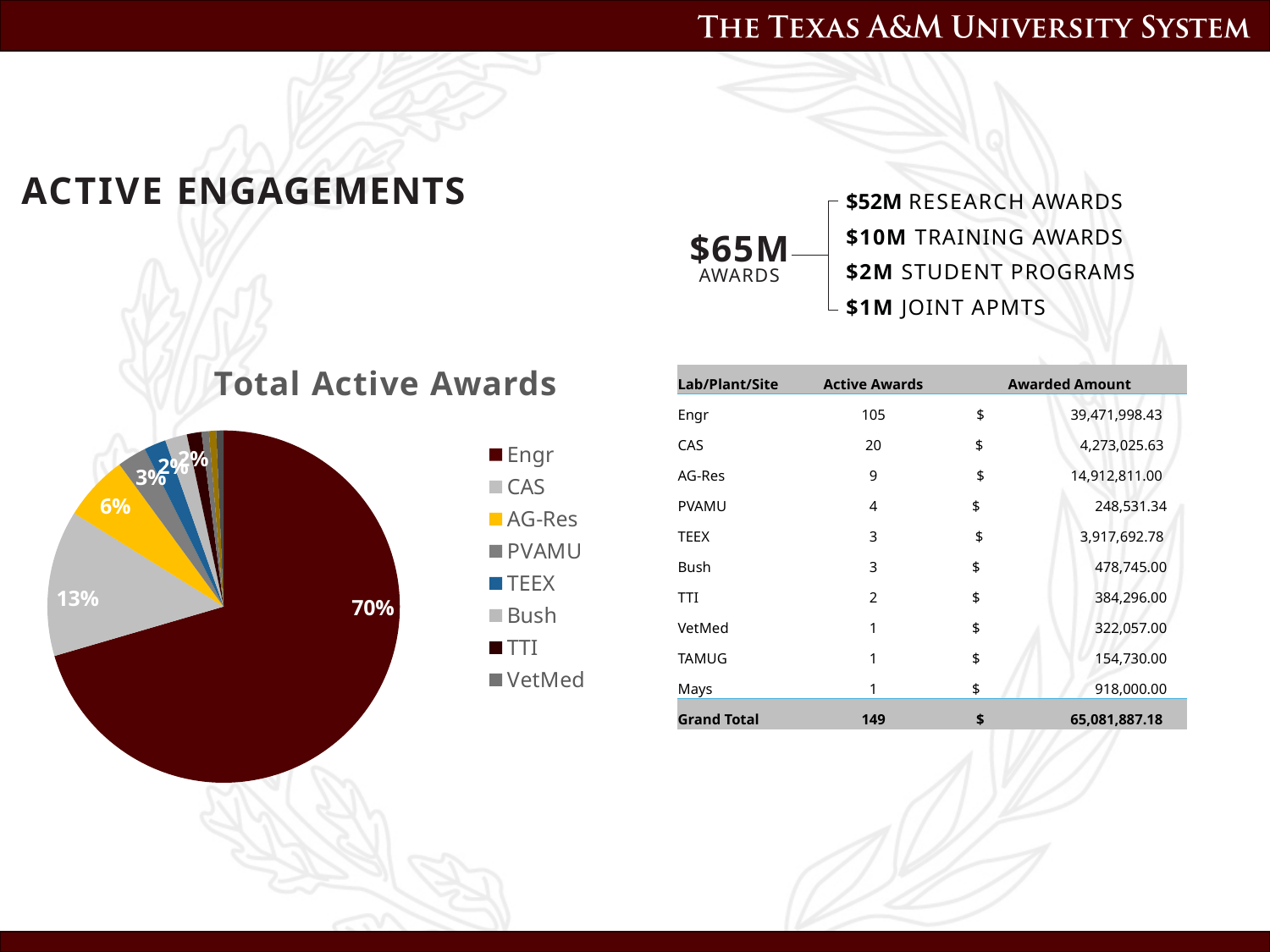
What colour is the Engr slice in the Total Active Awards pie chart? dark maroon How many entries does the legend of the Total Active Awards pie chart list? 8 What percentage is shown for CAS in the Total Active Awards pie chart? 13% In the Total Active Awards pie chart, how many percentage points larger is the CAS slice than the AG-Res slice? 7 What share of the Total Active Awards pie does Engr account for? 70% What kind of chart is shown under the title "Total Active Awards"? pie chart In the Total Active Awards pie chart, which slice is larger, CAS or AG-Res? CAS Which category has the largest slice in the Total Active Awards pie chart? Engr What percentage is shown for AG-Res in the Total Active Awards pie chart? 6% What is the title of the pie chart? Total Active Awards In the Total Active Awards pie chart, which slice is larger, Engr or AG-Res? Engr In the Total Active Awards pie chart, how many percentage points larger is the Engr slice than the CAS slice? 57